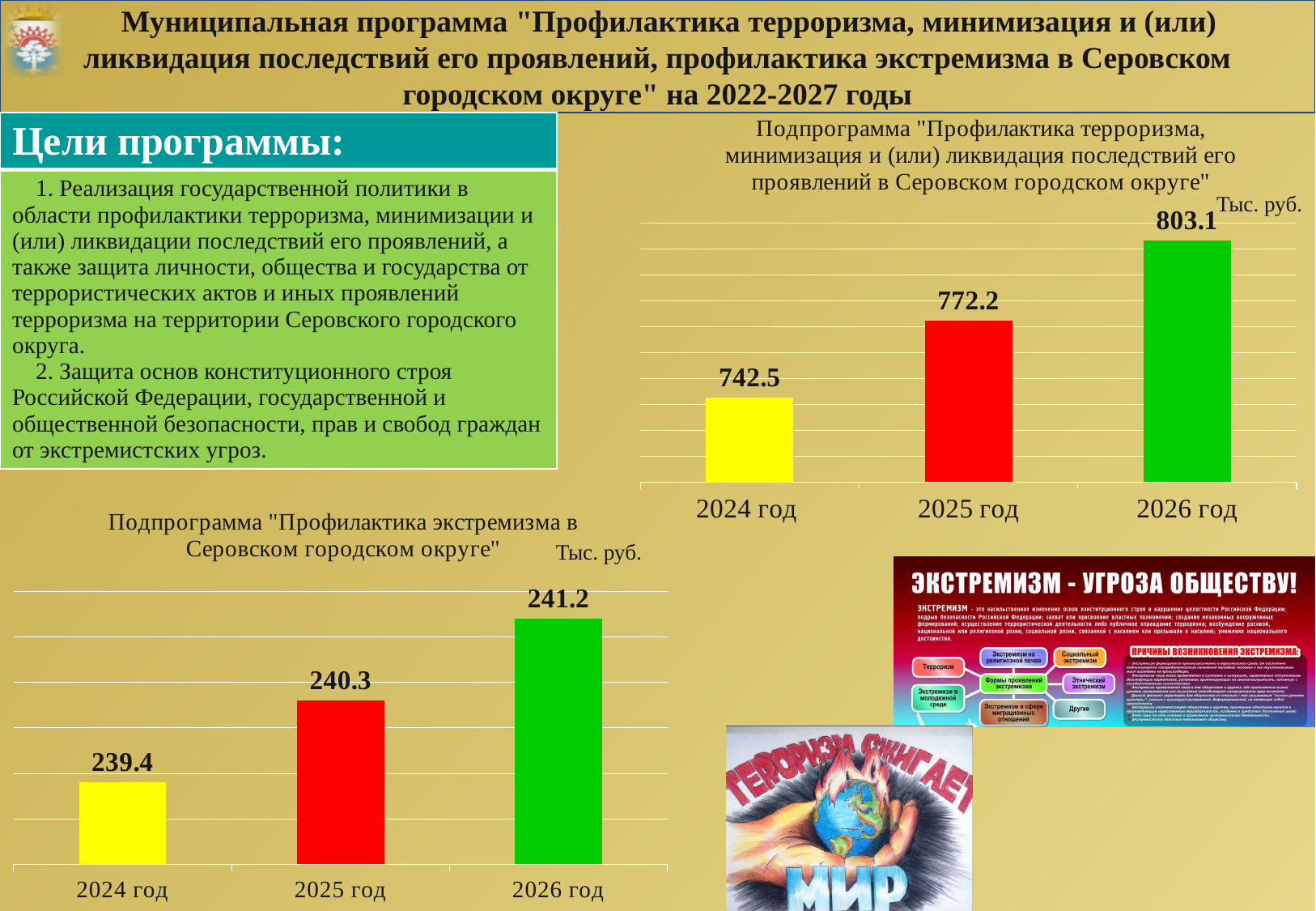
In the top-right chart about профилактика терроризма, which year has the highest value? 2026 год In the top-right chart about профилактика терроризма, what is the difference between the values for 2026 год and 2024 год? 60.6 In the chart titled "Подпрограмма "Профилактика экстремизма в Серовском городском округе"", what is the value for 2024 год? 239.4 In the bottom-left chart about профилактика экстремизма, how many years are shown on the x axis? 3 In the top-right chart about профилактика терроризма, do the values rise or fall from 2024 год to 2026 год? rise In the bottom-left chart about профилактика экстремизма, what is the difference between the values for 2025 год and 2024 год? 0.9 In the chart titled "Подпрограмма "Профилактика терроризма, минимизация и (или) ликвидация последствий его проявлений в Серовском городском округе"", what is the value for 2025 год? 772.2 What type of chart is the top-right chart about профилактика терроризма? bar chart In the bottom-left chart about профилактика экстремизма, which year has the lowest value? 2024 год In the chart titled "Подпрограмма "Профилактика экстремизма в Серовском городском округе"", what is the value for 2026 год? 241.2 In the bottom-left chart about профилактика экстремизма, what unit is indicated next to the chart? Тыс. руб. In the chart titled "Подпрограмма "Профилактика терроризма..."" (top right), what is the value for 2024 год? 742.5